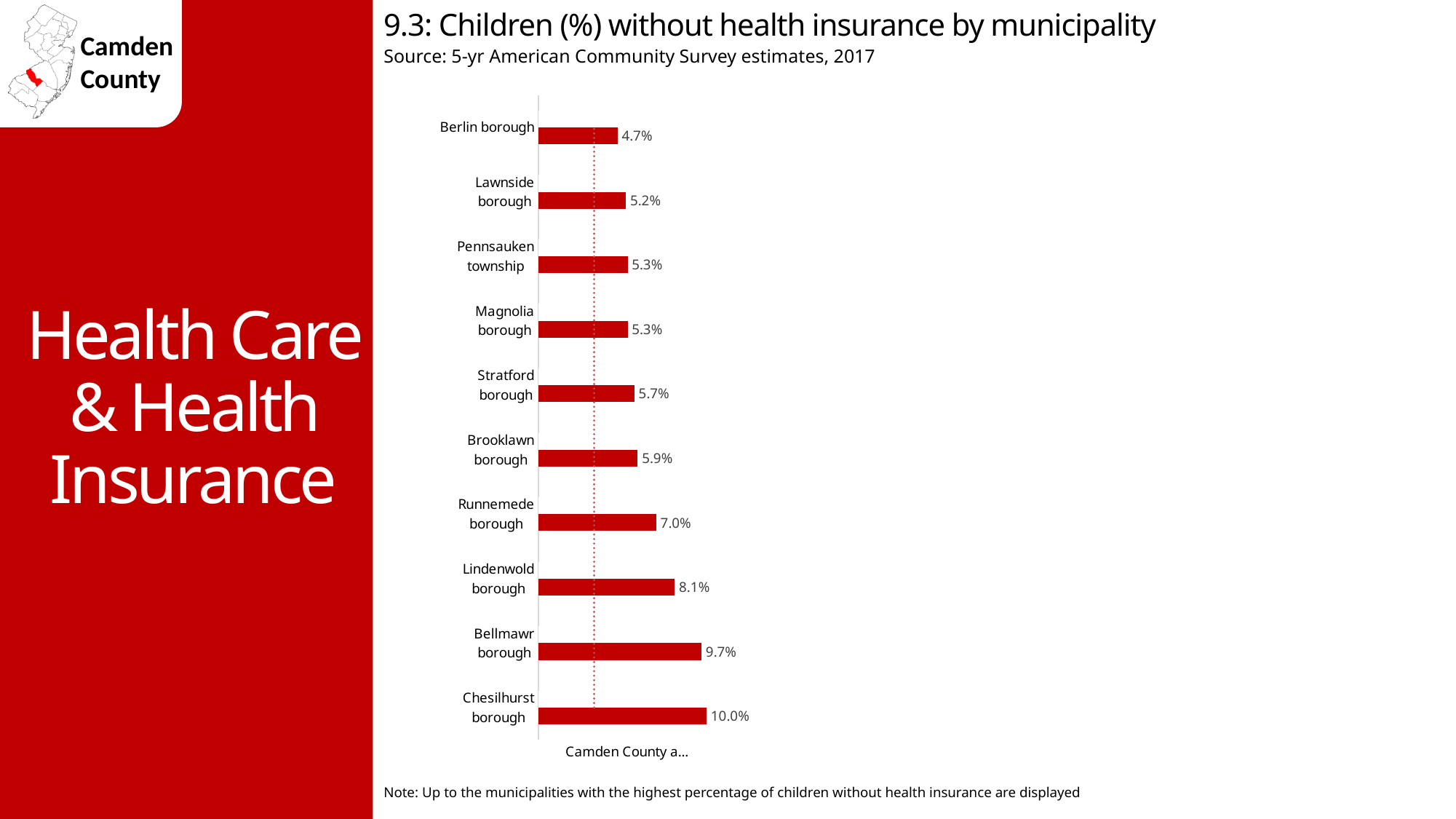
Which municipality has the lowest percentage of children without health insurance on the chart? Berlin borough What type of chart is used on this slide? Bar chart What percentage of children are without health insurance in Chesilhurst borough? 10.0% What percentage is shown for Runnemede borough? 7.0% Which has a higher percentage of children without health insurance, Brooklawn borough or Stratford borough? Brooklawn borough What is the difference between the values for Chesilhurst borough and Lindenwold borough? 1.9% Which municipality has the highest percentage of children without health insurance? Chesilhurst borough What is the value shown for Lindenwold borough? 8.1% How many municipalities are shown on the chart? 10 Which has a higher value, Bellmawr borough or Runnemede borough? Bellmawr borough What is the difference between the values for Bellmawr borough and Berlin borough? 5.0% What is the source of the data shown in the chart? 5-yr American Community Survey estimates, 2017